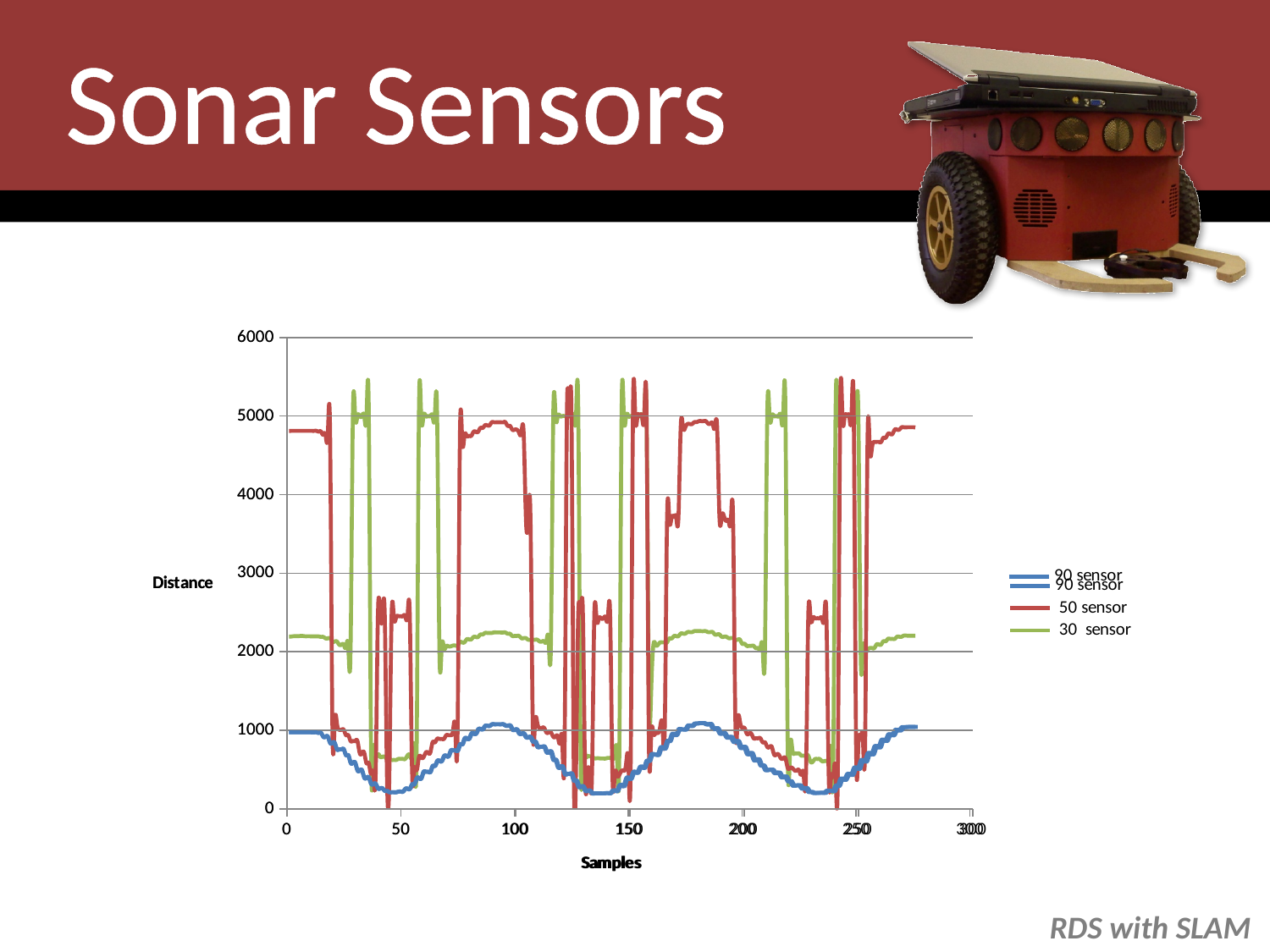
What is the title of the y axis of the chart? Distance Is the lowest value reached by the 90 sensor series greater or less than 1000? less At sample 0, which series has the lowest distance value? 90 sensor At sample 0, which series has the highest distance value? 50 sensor What kind of chart is shown on the slide? line chart Is the highest value reached by the 90 sensor series greater or less than 2000? less At sample 0, which series has the larger value, the 30 sensor or the 90 sensor? 30 sensor What is the title of the x axis of the chart? Samples Is the value of the 30 sensor series at sample 0 greater or less than 2000? greater How many sensor series does the chart plot? 3